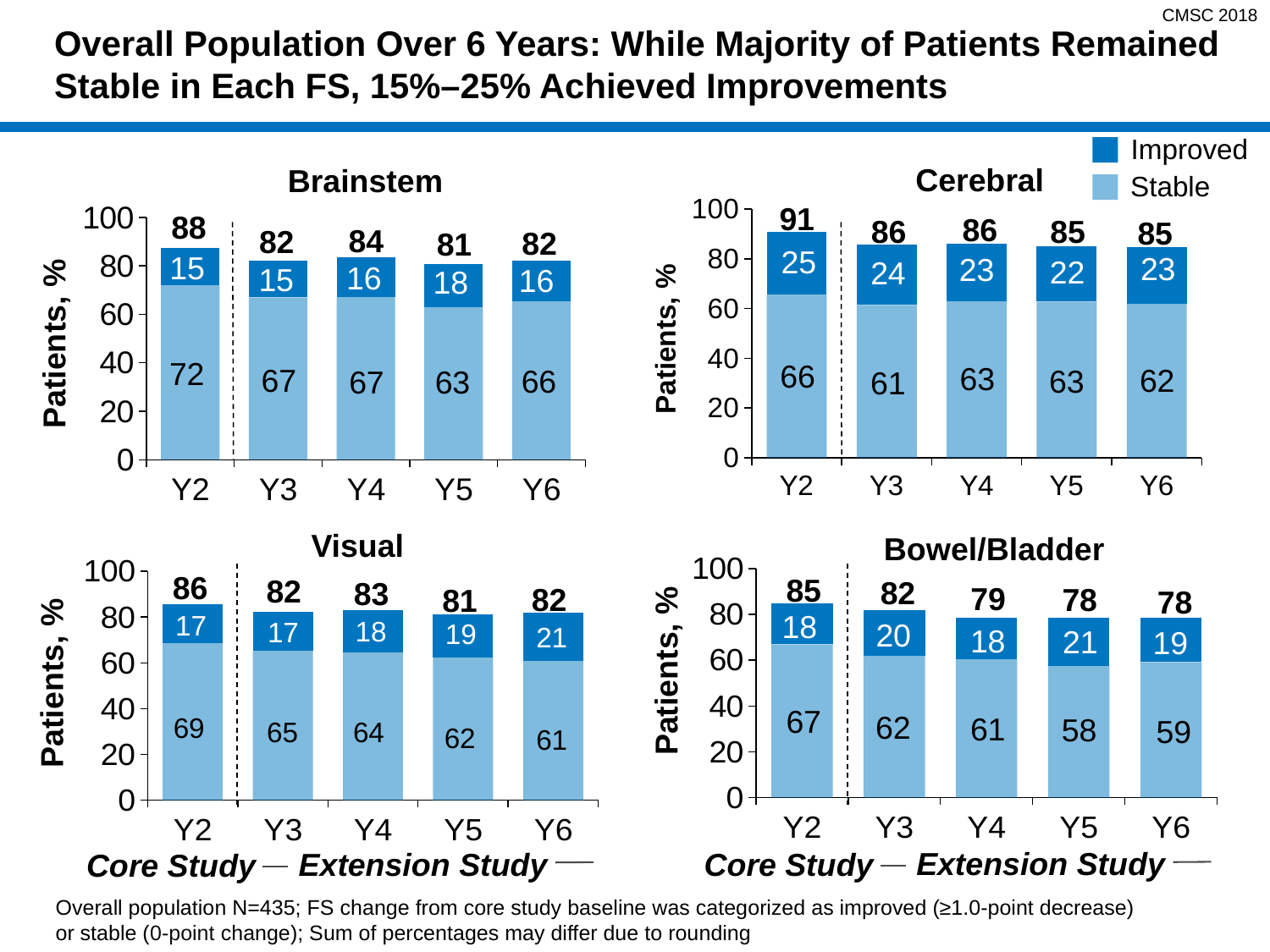
In the Brainstem chart, what is the Stable value for Y2? 72 In the Visual chart, is the total for Y2 greater or less than 80? greater In the Brainstem chart, which is larger, the Improved value for Y5 or for Y6? Y5 In the Cerebral chart, what is the Improved value for Y3? 24 In the Cerebral chart, what is the difference between the Stable values for Y2 and Y3? 5 How many years are shown on the x axis of the Cerebral chart? 5 In the Bowel/Bladder chart, do the totals rise or fall from Y2 to Y5? Fall In the Bowel/Bladder chart, what is the total printed above the Y5 bar? 78 How many series does the legend list? 2 In the Bowel/Bladder chart, which year has the lowest Stable value? Y5 What kind of chart is the Bowel/Bladder chart? Stacked bar chart In the Visual chart, which year has the highest total? Y2